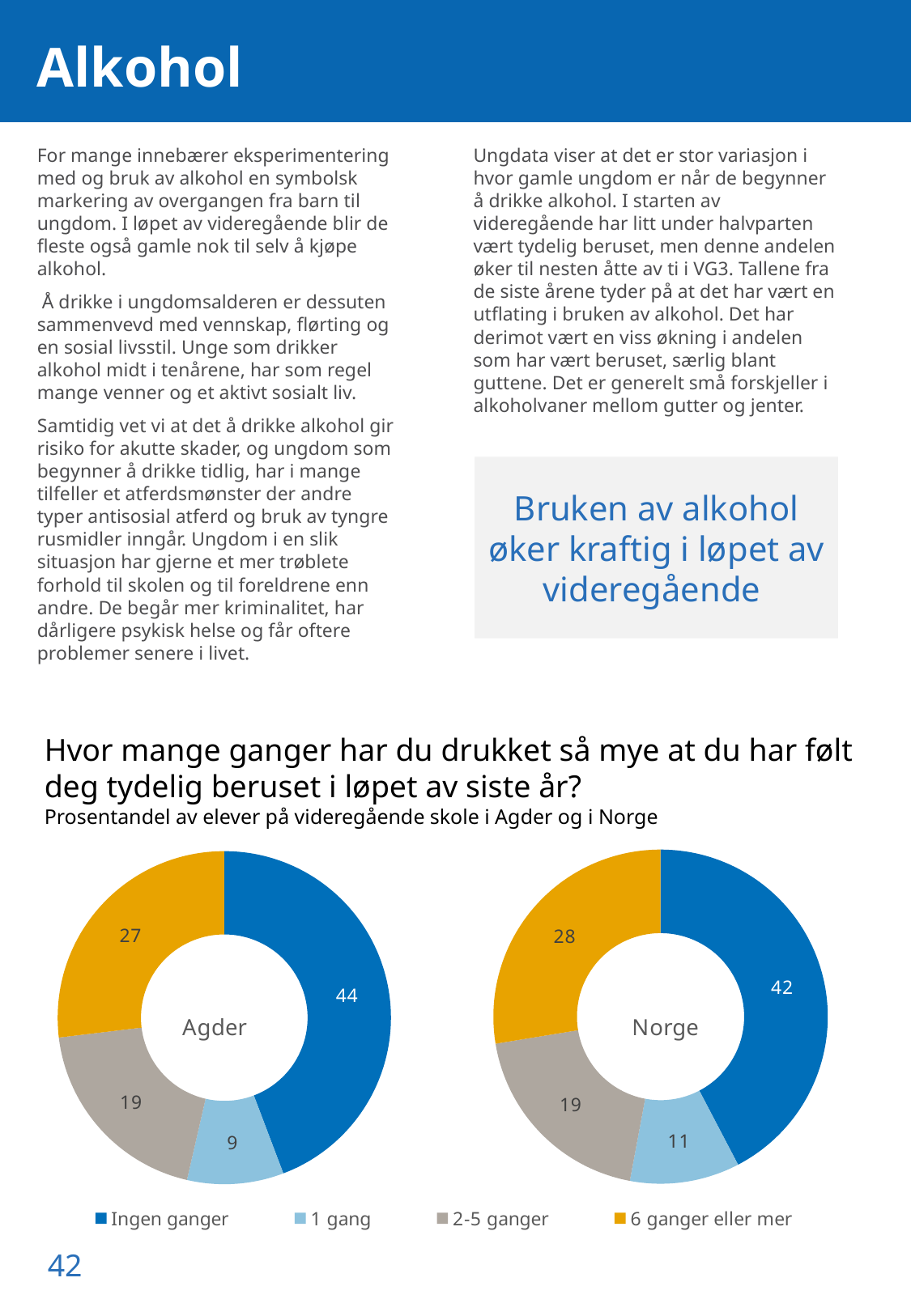
In the Agder chart, which category has the largest share? Ingen ganger In the Agder chart, what is the difference between '6 ganger eller mer' and '2-5 ganger'? 8 Which is larger: '1 gang' in the Agder chart or '1 gang' in the Norge chart? Norge In the Norge chart, which category has the smallest share? 1 gang In the Norge chart, what is the value for '2-5 ganger'? 19 In the Agder chart, what is the value for 'Ingen ganger'? 44 How many categories does the legend list for the charts? 4 What kind of chart is used for Agder and Norge? Doughnut (pie) chart What is the difference between the 'Ingen ganger' values in the Agder chart and the Norge chart? 2 Which colour represents '6 ganger eller mer' in the charts? Orange/yellow In the Norge chart, what is the value for '1 gang'? 11 In the Agder chart, what is the value for '6 ganger eller mer'? 27